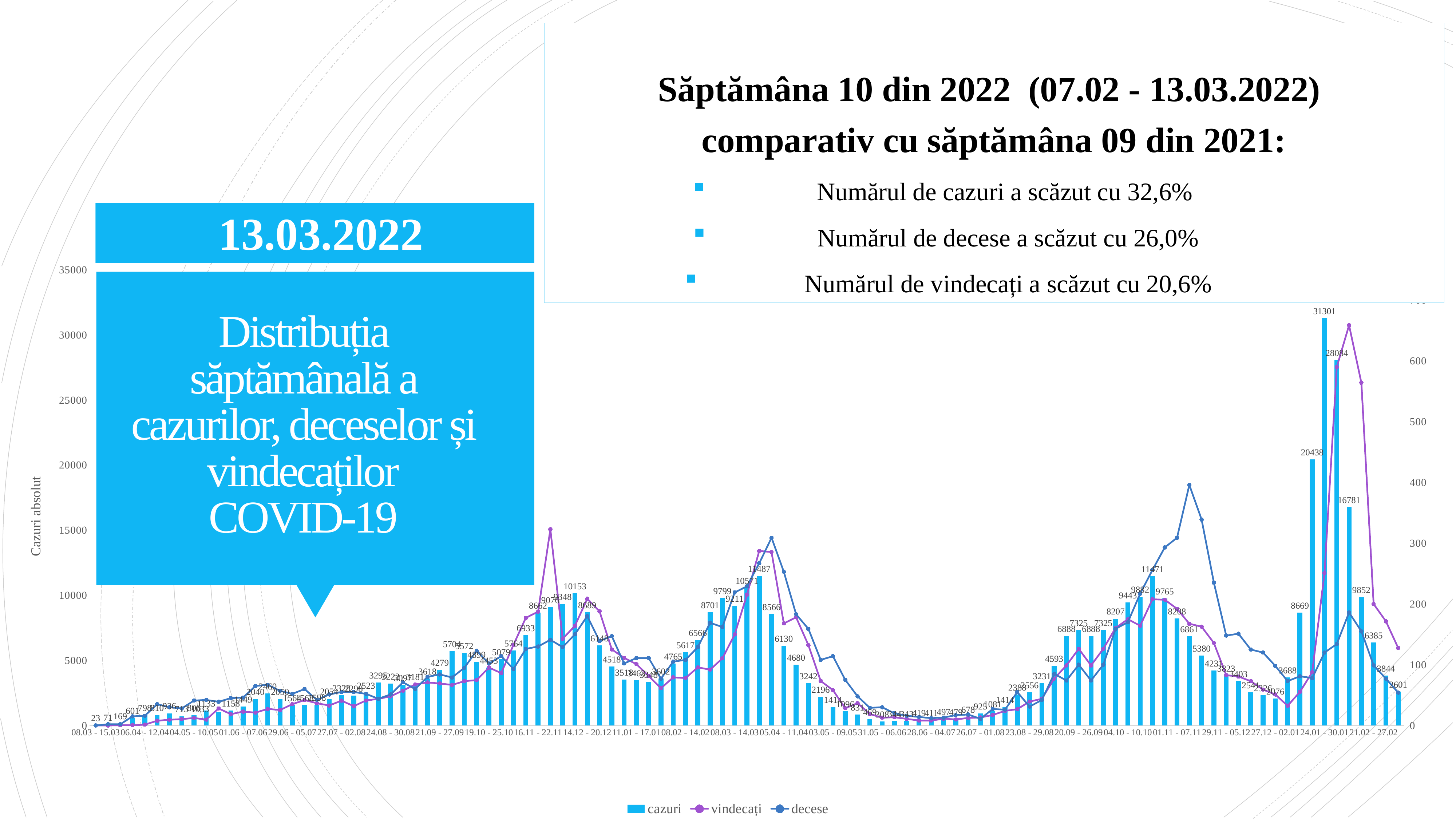
Is the tallest bar in the chart greater or less than 30000? greater Is the bar labelled 8669 greater or less than 10000? less How many series does the legend list? 3 What is the value labelled on the last bar of the chart? 2601 What kind of chart is shown on the slide? Combined bar and line chart What is the difference between the bars labelled 10153 and 9852? 301 What is the highest value shown on a bar in the chart? 31301 What is the value labelled on the first bar of the chart? 23 What is the title of the left vertical axis? Cazuri absolut What is the difference between the two tallest bars, labelled 31301 and 28084? 3217 What are the three series named in the legend? cazuri, vindecați, decese Which is larger, the bar labelled 20438 or the bar labelled 16781? 20438